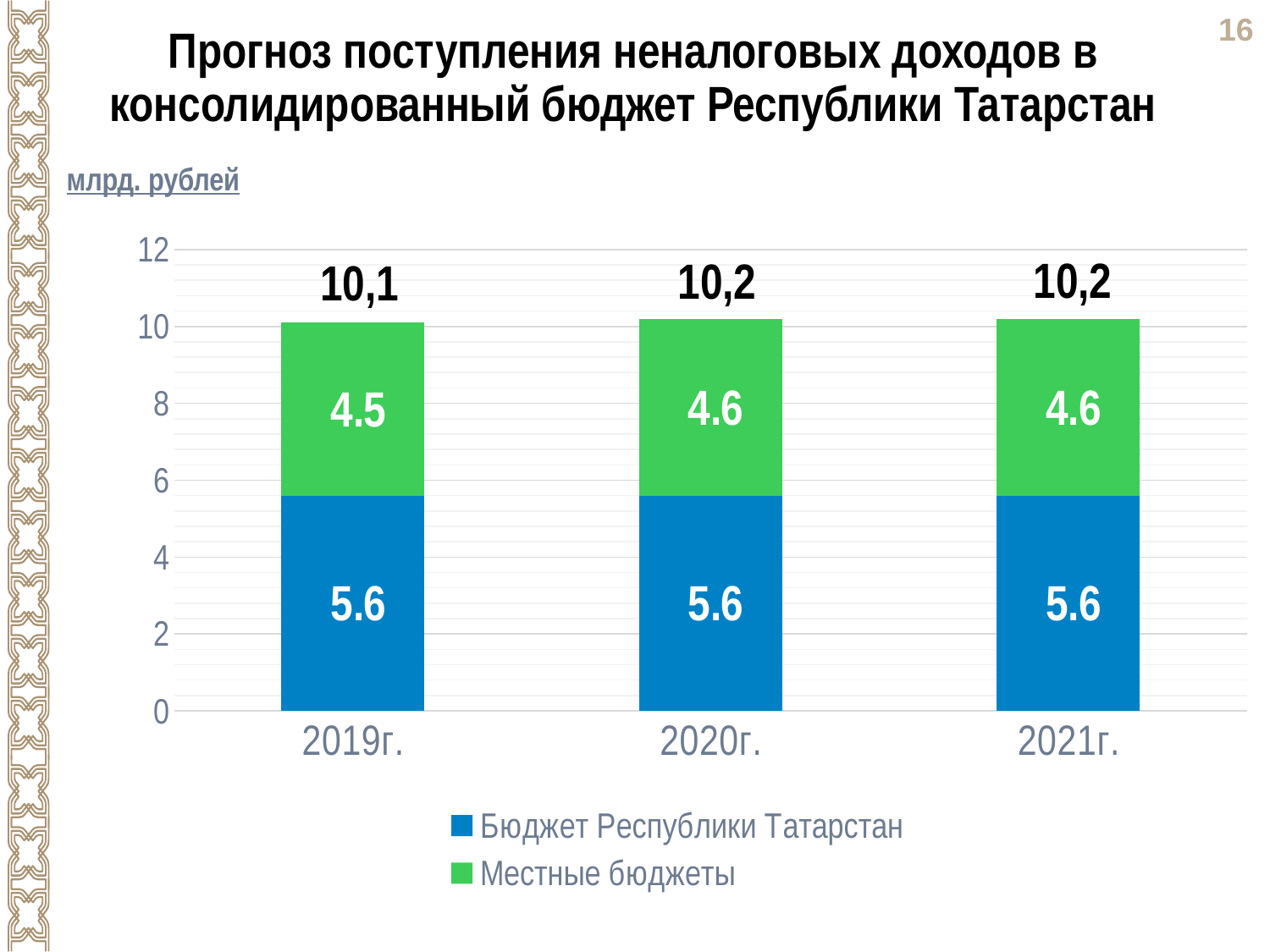
What unit is stated above the chart? млрд. рублей How many years are shown on the x axis? 3 What is the value for Местные бюджеты in 2019г.? 4.5 What is the total of the stacked bar for 2019г.? 10,1 What kind of chart is shown? Stacked bar chart What is the difference between the Местные бюджеты values for 2020г. and 2019г.? 0.1 How many series does the legend list? 2 What is the total of the stacked bar for 2021г.? 10,2 What is the value for Местные бюджеты in 2020г.? 4.6 What is the value for Бюджет Республики Татарстан in 2019г.? 5.6 Which year has the lowest total? 2019г. In 2021г., which is larger: Бюджет Республики Татарстан or Местные бюджеты? Бюджет Республики Татарстан